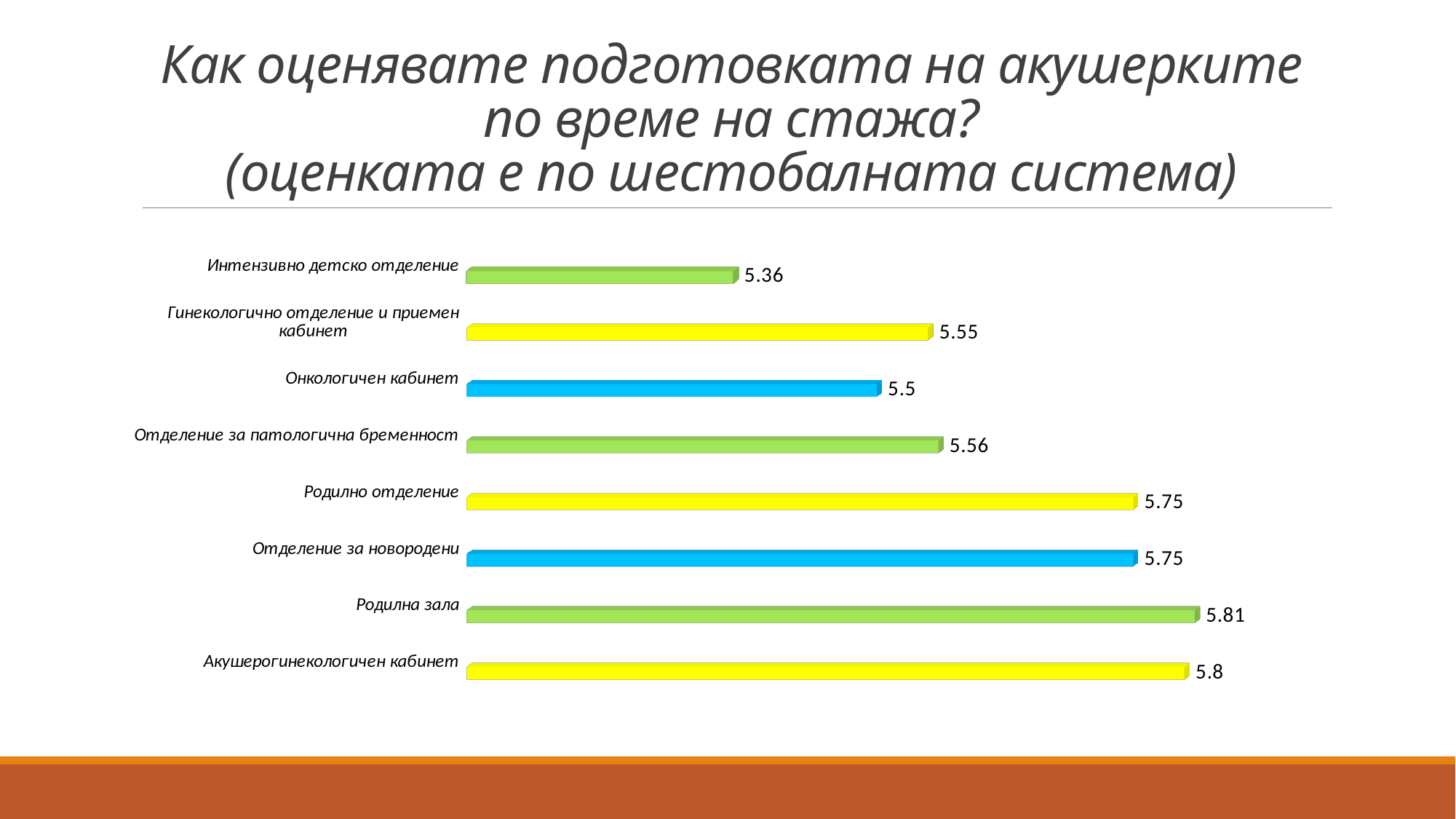
How many categories are shown in the chart? 8 What kind of chart is shown on the slide? Bar chart What is the value for Отделение за патологична бременност? 5.56 What is the difference between the values for Родилна зала and Акушерогинекологичен кабинет? 0.01 Which category has the lowest value? Интензивно детско отделение Which category has the highest value? Родилна зала What is the difference between the values for Родилно отделение and Интензивно детско отделение? 0.39 What is the value for Онкологичен кабинет? 5.5 What is the value for Интензивно детско отделение? 5.36 What is the value for Акушерогинекологичен кабинет? 5.8 Which is larger, the value for Гинекологично отделение и приемен кабинет or the value for Онкологичен кабинет? Гинекологично отделение и приемен кабинет What is the value for Родилна зала? 5.81